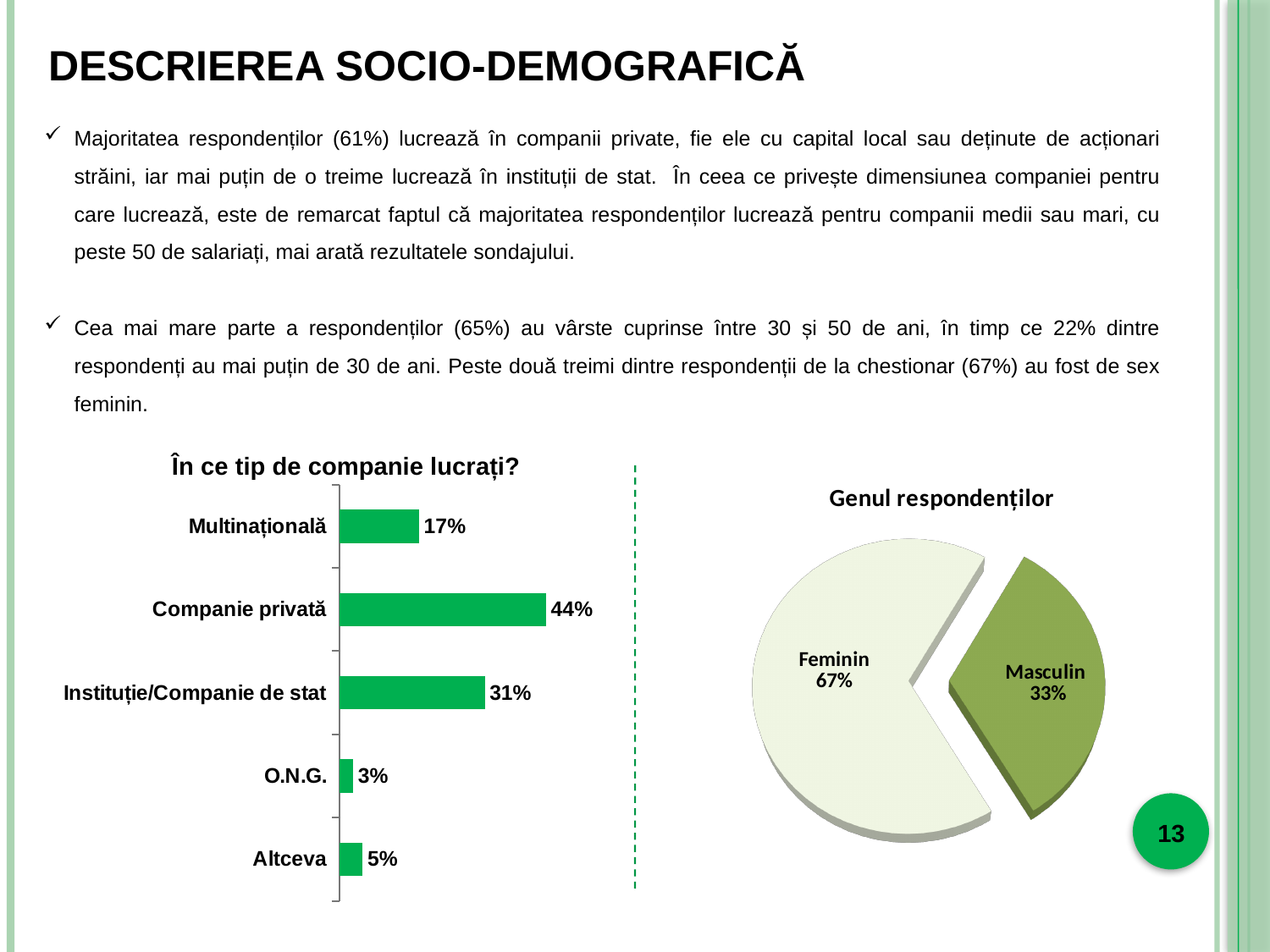
In the chart "În ce tip de companie lucrați?", what is the value for Companie privată? 44% In the chart "În ce tip de companie lucrați?", which category has the highest value? Companie privată In the chart "În ce tip de companie lucrați?", what is the difference between Companie privată and Multinațională? 27% In the chart "Genul respondenților", what share of the pie is Masculin? 33% In the chart "Genul respondenților", what is the difference between the Feminin and Masculin shares? 34% In the chart "În ce tip de companie lucrați?", what is the value for Instituție/Companie de stat? 31% In the chart "În ce tip de companie lucrați?", which category has the lowest value? O.N.G. What kind of chart is "Genul respondenților"? Pie chart In the chart "În ce tip de companie lucrați?", which is larger: Altceva or O.N.G.? Altceva What kind of chart is "În ce tip de companie lucrați?"? Bar chart In the chart "Genul respondenților", what share of the pie is Feminin? 67% How many categories are shown in the chart "În ce tip de companie lucrați?"? 5